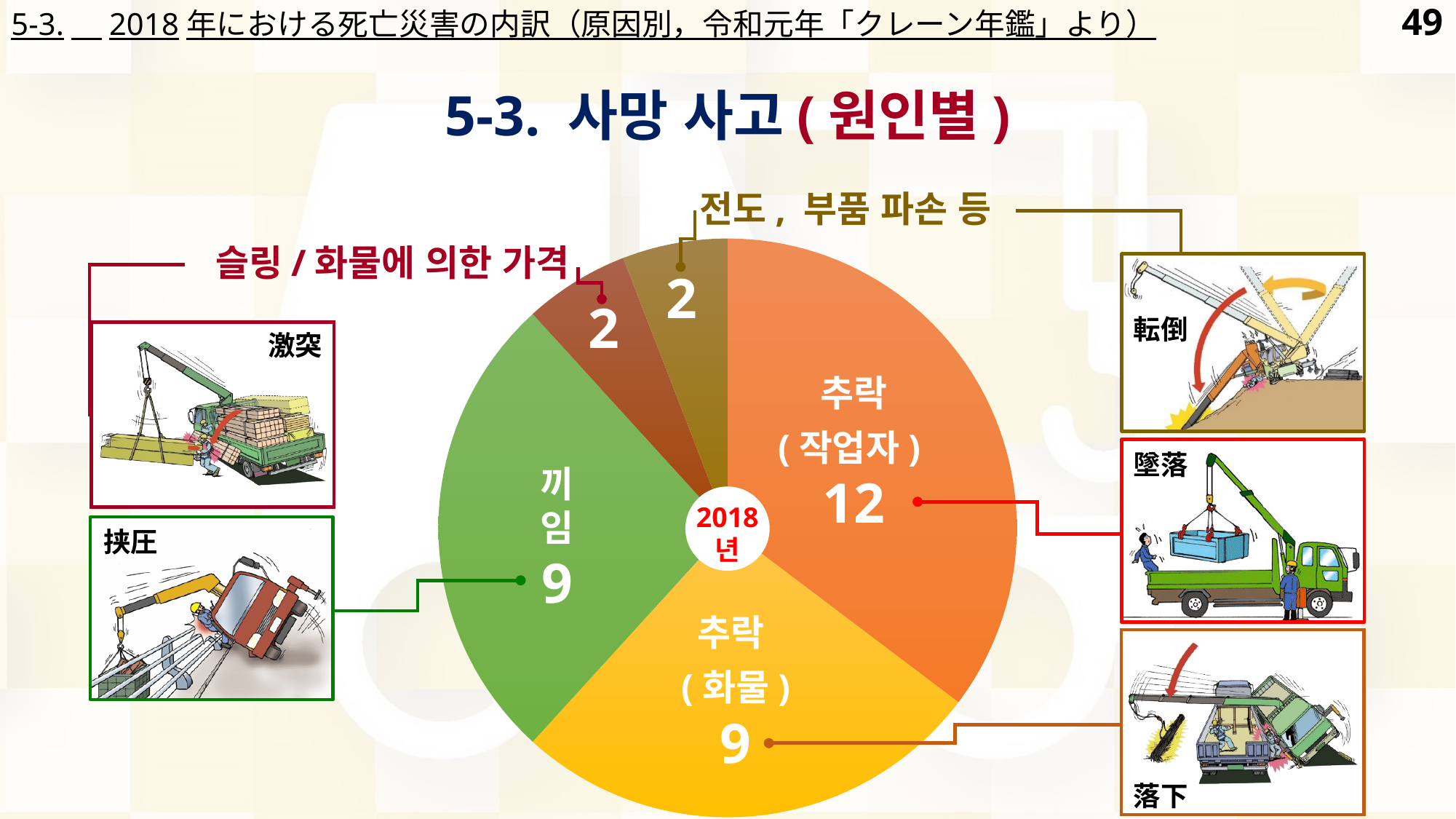
Which category has the largest slice in the pie chart? 추락 (작업자) How many slices does the pie chart have? 5 What is the value for 슬링 / 화물에 의한 가격 in the pie chart? 2 What is the total of all the values shown in the pie chart? 34 What is the value for 추락 (화물) in the pie chart? 9 What is the value for 추락 (작업자) in the pie chart? 12 What year is written in the centre of the pie chart? 2018년 What kind of chart is shown on the slide? pie chart What is the value for 끼임 in the pie chart? 9 What is the difference between the value for 추락 (작업자) and the value for 추락 (화물)? 3 What is the value for 전도, 부품 파손 등 in the pie chart? 2 Which is larger, the value for 추락 (작업자) or the value for 끼임? 추락 (작업자)